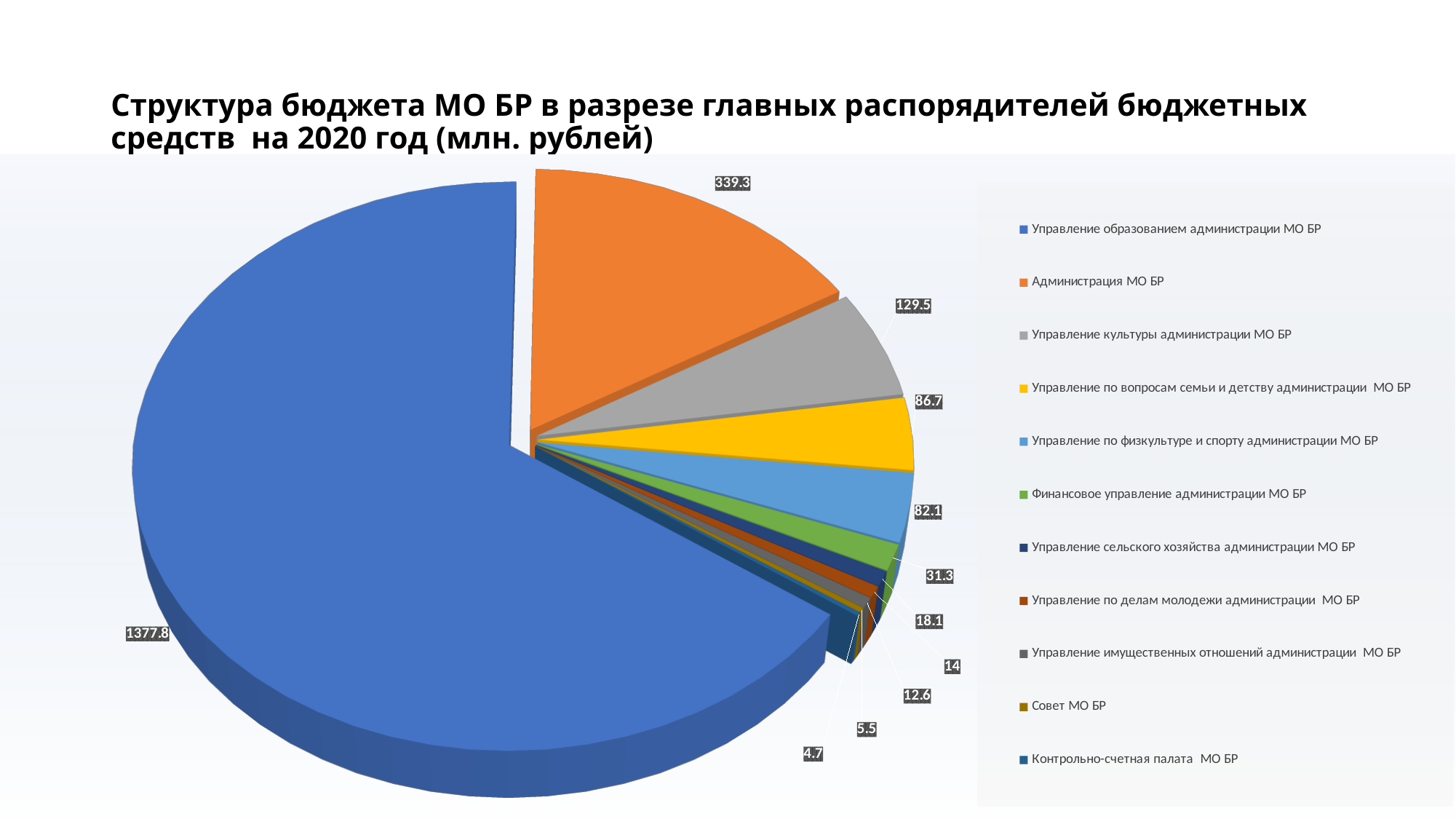
What is the value for Управление культуры администрации МО БР? 129.5 What is the value for Управление образованием администрации МО БР? 1377.8 What is the value for Финансовое управление администрации МО БР? 31.3 What type of chart is shown on the slide? Pie chart What is the title of the chart on the slide? Структура бюджета МО БР в разрезе главных распорядителей бюджетных средств на 2020 год (млн. рублей) What is the difference between the values for Администрация МО БР and Управление культуры администрации МО БР? 209.8 Which category has the smallest slice of the pie? Контрольно-счетная палата МО БР What is the value for Администрация МО БР? 339.3 Which category has the largest slice of the pie? Управление образованием администрации МО БР How many categories does the pie chart have? 11 What is the value for Управление по вопросам семьи и детству администрации МО БР? 86.7 Which is larger: the value for Управление по физкультуре и спорту администрации МО БР or the value for Финансовое управление администрации МО БР? Управление по физкультуре и спорту администрации МО БР